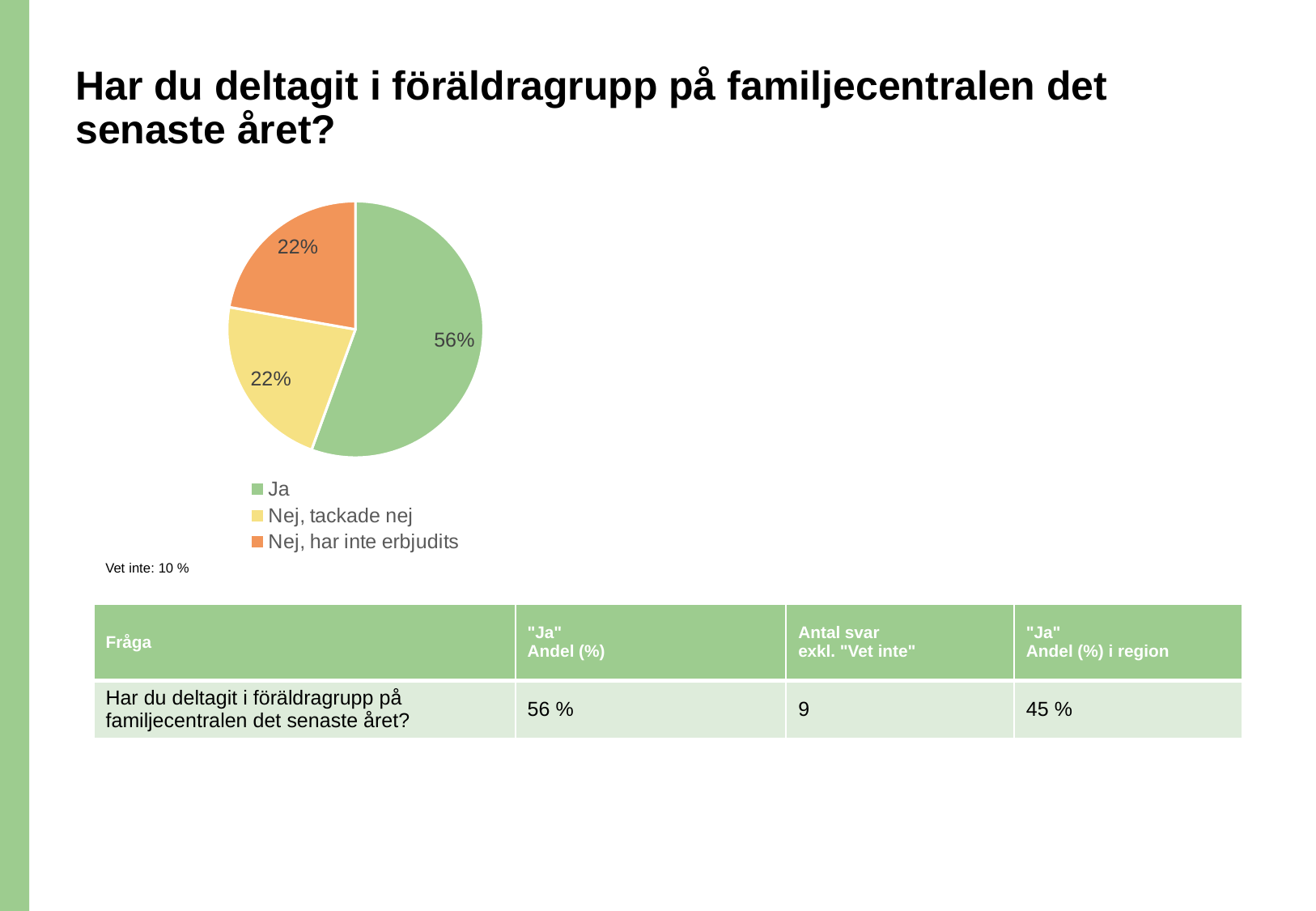
How many slices does the pie chart have? 3 What is the difference in percentage points between the "Ja" slice and the "Nej, tackade nej" slice? 34 percentage points What percentage of the pie chart is the "Nej, har inte erbjudits" slice? 22% What kind of chart is shown on the slide? Pie chart Which category has the largest slice in the pie chart? Ja Which slice is larger, "Ja" or "Nej, har inte erbjudits"? Ja What is the title of the slide containing the pie chart? Har du deltagit i föräldragrupp på familjecentralen det senaste året? What colour is the "Ja" slice in the pie chart? Green What percentage of the pie chart is the "Ja" slice? 56% What percentage of the pie chart is the "Nej, tackade nej" slice? 22% How many entries does the legend of the pie chart list? 3 What share of the pie does the "Ja" slice represent? 56%